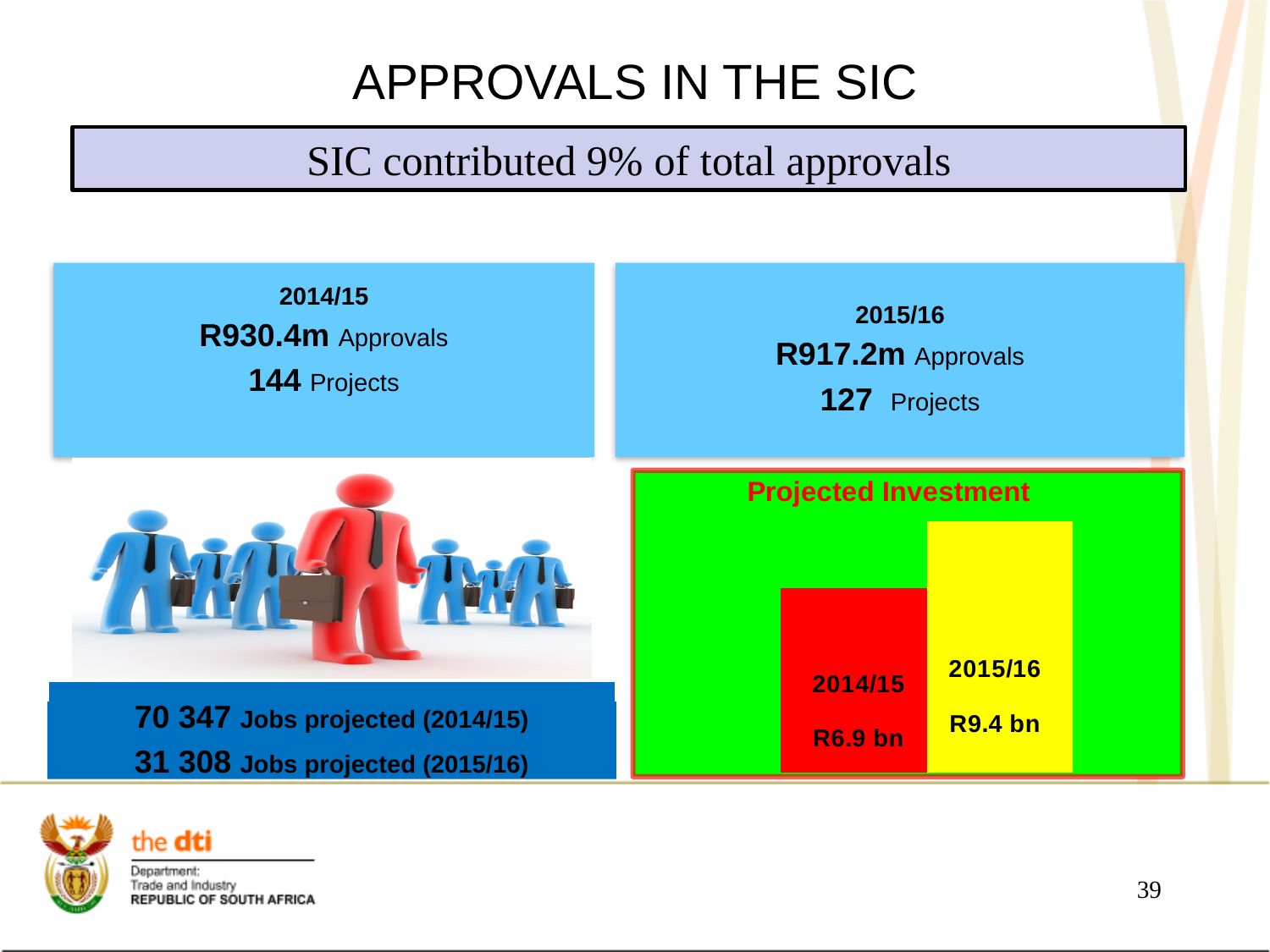
In the Projected Investment chart, which year has the highest projected investment? 2015/16 In the Projected Investment chart, what is the projected investment for 2015/16? R9.4 bn In the Projected Investment chart, what is the difference between the 2015/16 and 2014/15 projected investment? R2.5 bn What kind of chart is the Projected Investment chart? Bar chart In the Projected Investment chart, what is the projected investment for 2014/15? R6.9 bn How many bars are shown in the Projected Investment chart? 2 In the Projected Investment chart, does the projected investment rise or fall from 2014/15 to 2015/16? Rise In the Projected Investment chart, which year has the lowest projected investment? 2014/15 In the Projected Investment chart, what colour is the 2015/16 bar? Yellow In the Projected Investment chart, is the projected investment larger for 2014/15 or 2015/16? 2015/16 What is the title of the chart on the slide? Projected Investment